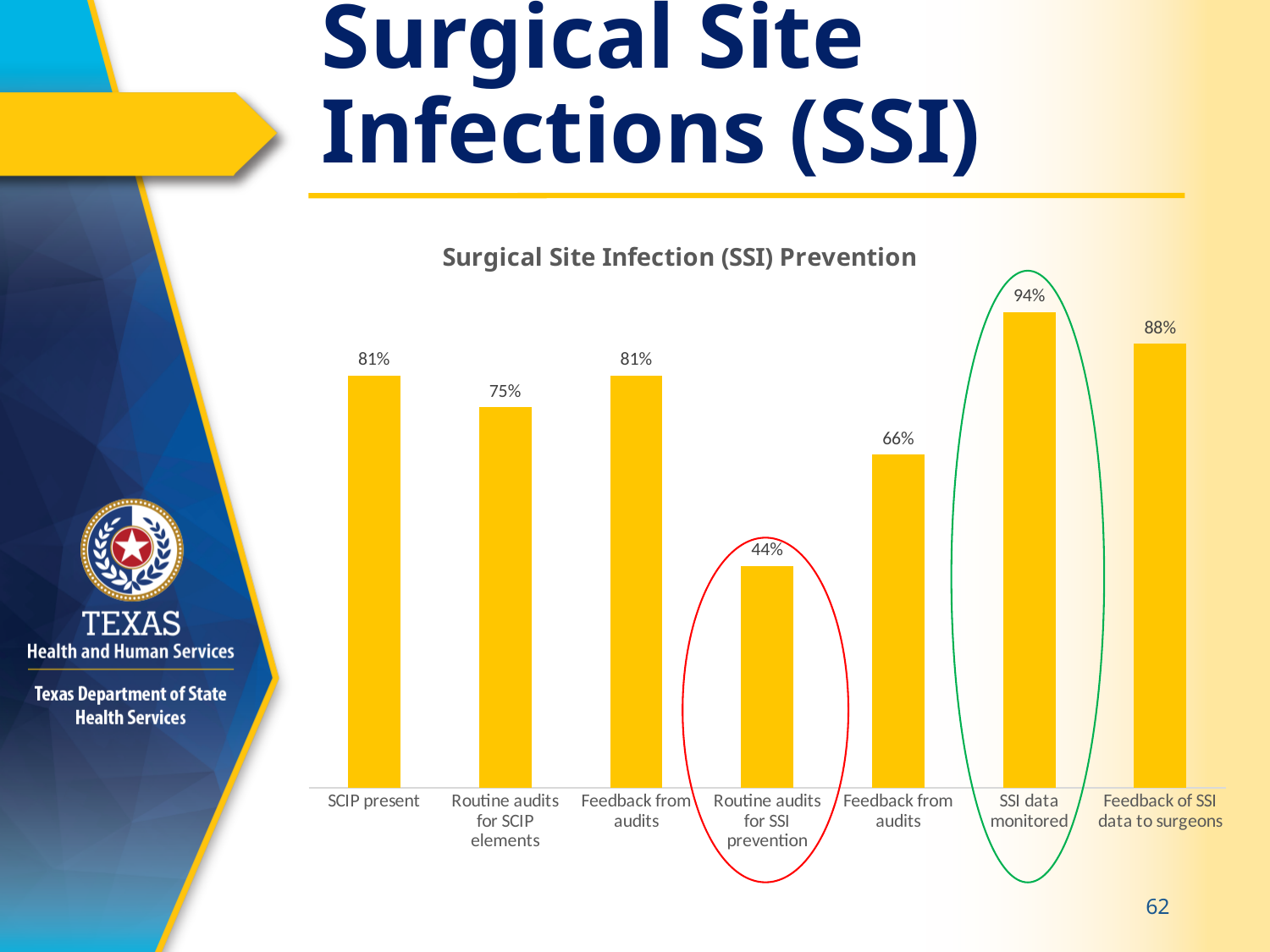
What is the value for SCIP present? 81% What is the value for Feedback of SSI data to surgeons? 88% What is the value for Routine audits for SSI prevention? 44% Which is larger, the value for Feedback of SSI data to surgeons or the value for Routine audits for SCIP elements? Feedback of SSI data to surgeons What is the title of the chart? Surgical Site Infection (SSI) Prevention Which category has the highest value? SSI data monitored Which category has the lowest value? Routine audits for SSI prevention What is the difference between the values for SSI data monitored and Routine audits for SSI prevention? 50% What is the value for SSI data monitored? 94% How many categories are shown in the chart? 7 What kind of chart is shown on the slide? Bar chart What is the value for Routine audits for SCIP elements? 75%